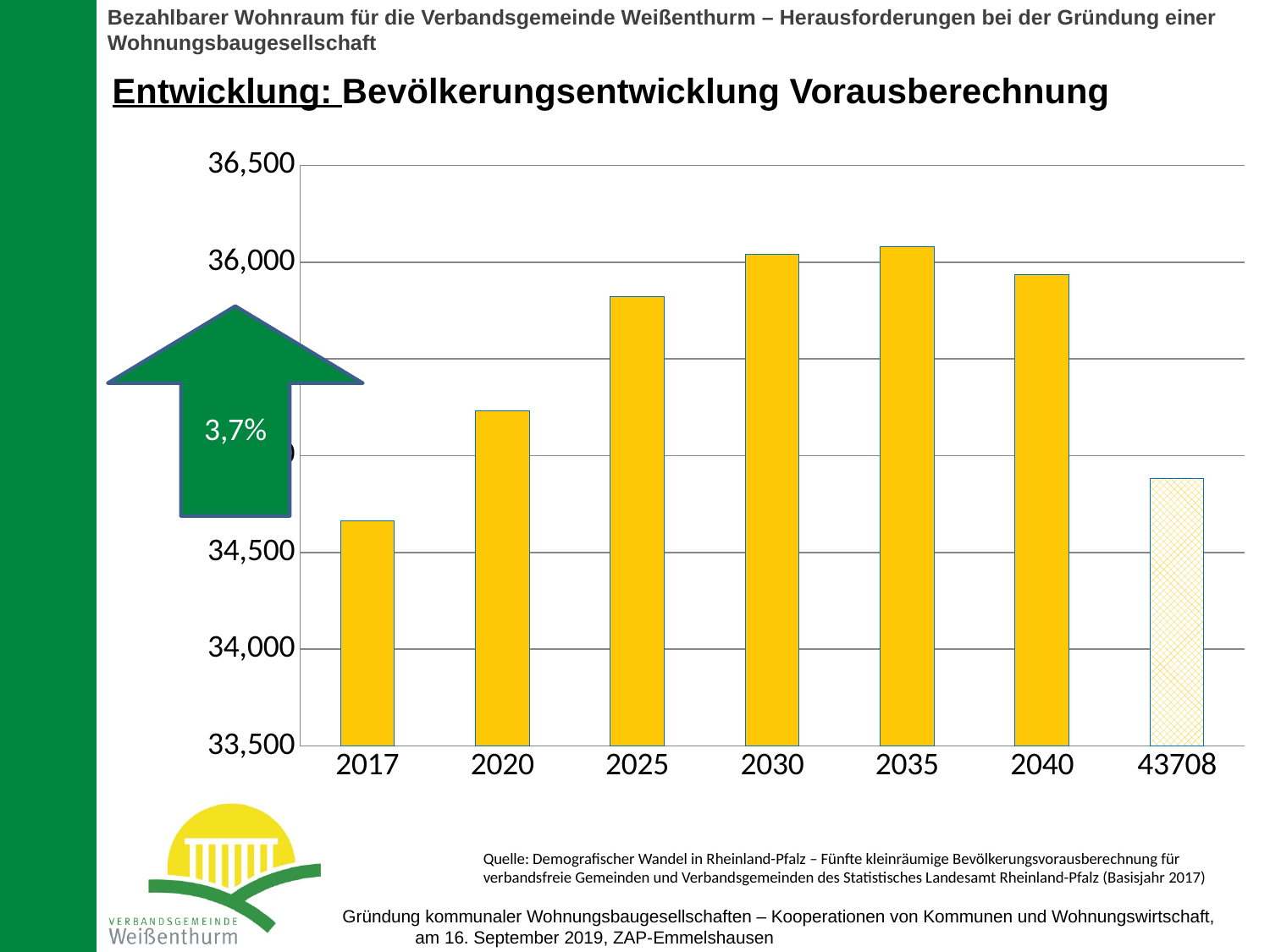
Do the bar values rise or fall from 2017 to 2035? rise Is the value for 2025 greater or less than 36,000? less Is the value for 43708 greater or less than 34,500? greater What percentage is printed on the green arrow next to the chart? 3,7% How many categories are shown on the x axis of the chart? 7 Which is larger, the value for 2017 or the value for 43708? 43708 Is the value for 2040 greater or less than 36,000? less What kind of chart is shown on the slide? bar chart Which is larger, the value for 2025 or the value for 2040? 2040 Which is larger, the value for 2017 or the value for 2020? 2020 Which category has the lowest bar in the chart? 2017